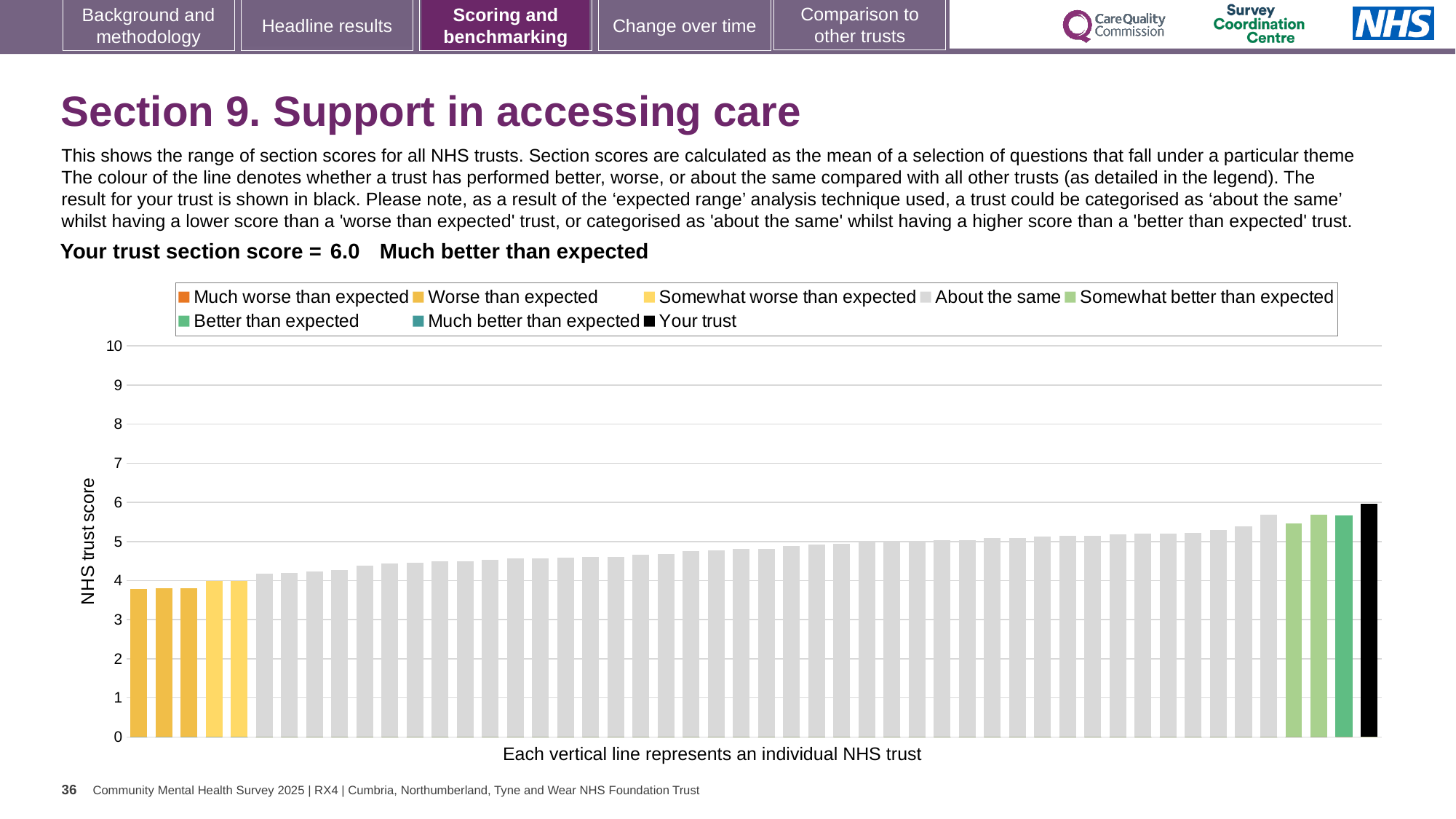
Do the bar values rise or fall from left to right across the chart? rise What is the section score for your trust shown on the slide? 6.0 What is the highest value shown on the vertical axis of the chart? 10 Which bar in the chart is the highest? Your trust Is the value of the highest bar in the chart greater or less than 7? less How many entries does the chart legend list? 8 Is the value of the black 'Your trust' bar greater or less than 5? greater What is the label on the vertical axis of the chart? NHS trust score Is the value of the leftmost bar in the chart greater or less than 4? less What kind of chart is shown on the slide? bar chart Which legend entry corresponds to the black bar in the chart? Your trust